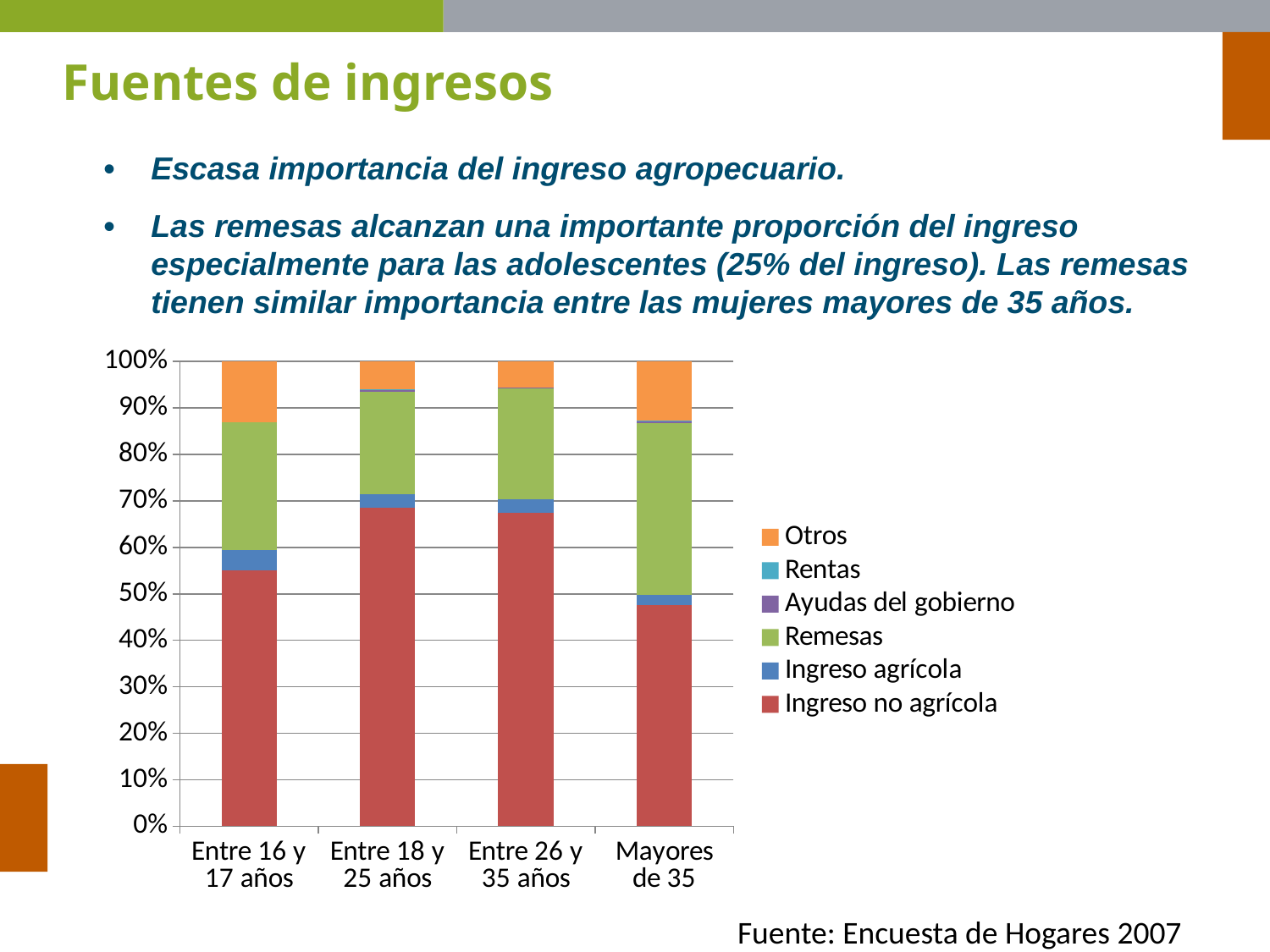
Which series is listed first in the chart's legend? Otros What does each stacked bar in the chart total? 100% Is the value of Ingreso no agrícola for Mayores de 35 greater or less than 50%? less Is the value of Ingreso no agrícola for Entre 16 y 17 años greater or less than 50%? greater Which age group has the lowest share of Ingreso no agrícola? Mayores de 35 What kind of chart is shown on the slide? Stacked bar chart How many age-group categories are shown on the x axis of the chart? 4 How many series does the chart's legend list? 6 Which age group has the largest share of Remesas? Mayores de 35 Is the value of Ingreso no agrícola for Entre 18 y 25 años greater or less than 60%? greater Which is larger, the Remesas share for Entre 18 y 25 años or for Mayores de 35? Mayores de 35 Which is larger, the Ingreso no agrícola share for Entre 16 y 17 años or for Mayores de 35? Entre 16 y 17 años